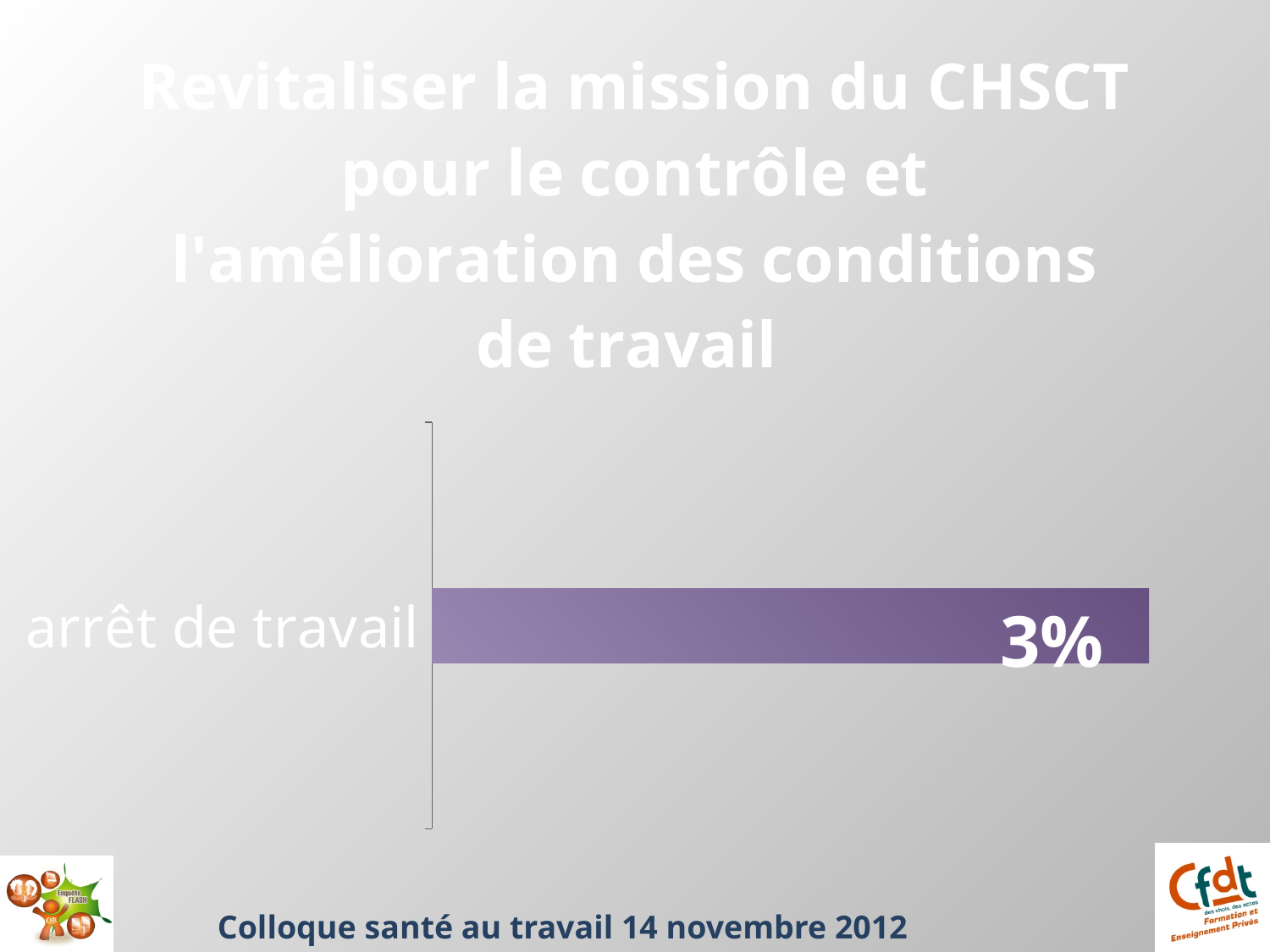
Is the value for "arrêt de travail" greater or less than 10%? less What kind of chart is shown on the slide? bar chart Are the bars in the chart horizontal or vertical? horizontal What is the label of the only category in the chart? arrêt de travail How many categories does the chart show? 1 What is the value shown for "arrêt de travail"? 3%